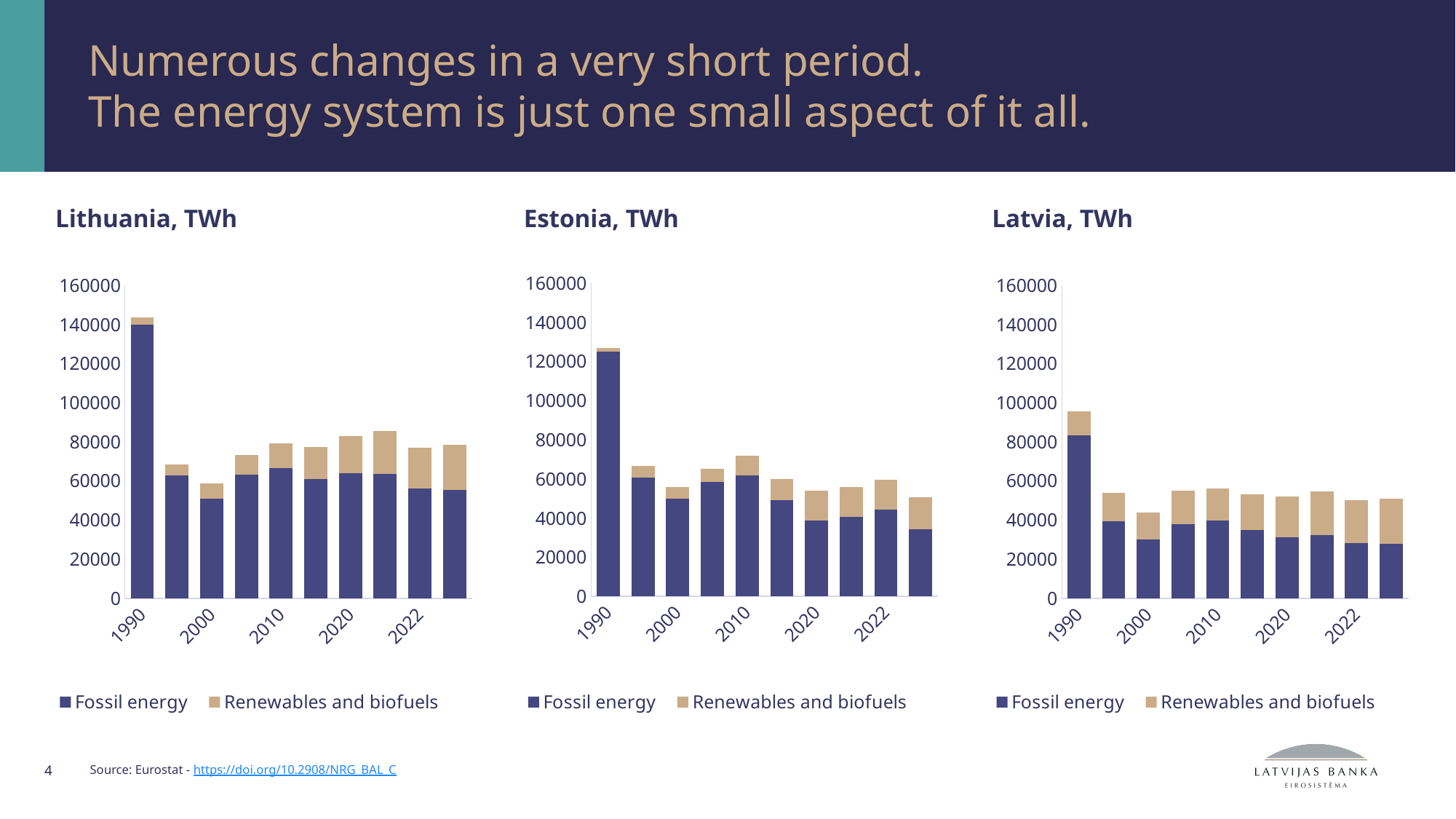
What kind of chart is the Lithuania, TWh chart? Stacked bar chart How many series does the legend of the Estonia, TWh chart list? 2 In the Estonia, TWh chart, does the Fossil energy value rise or fall from 2010 to 2022? Fall In the Lithuania, TWh chart, which year has the highest total bar? 1990 In the Estonia, TWh chart, is the total value for 1990 greater or less than 120000? greater How many bars are plotted in the Latvia, TWh chart? 10 Which is larger: the 1990 total bar in the Lithuania, TWh chart or the 1990 total bar in the Latvia, TWh chart? Lithuania In the Latvia, TWh chart, is the total value for 1990 greater or less than 100000? less In the Lithuania, TWh chart, is the Fossil energy value for 2022 greater or less than 60000? less In the Latvia, TWh chart, which year has the highest total bar? 1990 What are the two legend entries shown under the Lithuania, TWh chart? Fossil energy; Renewables and biofuels